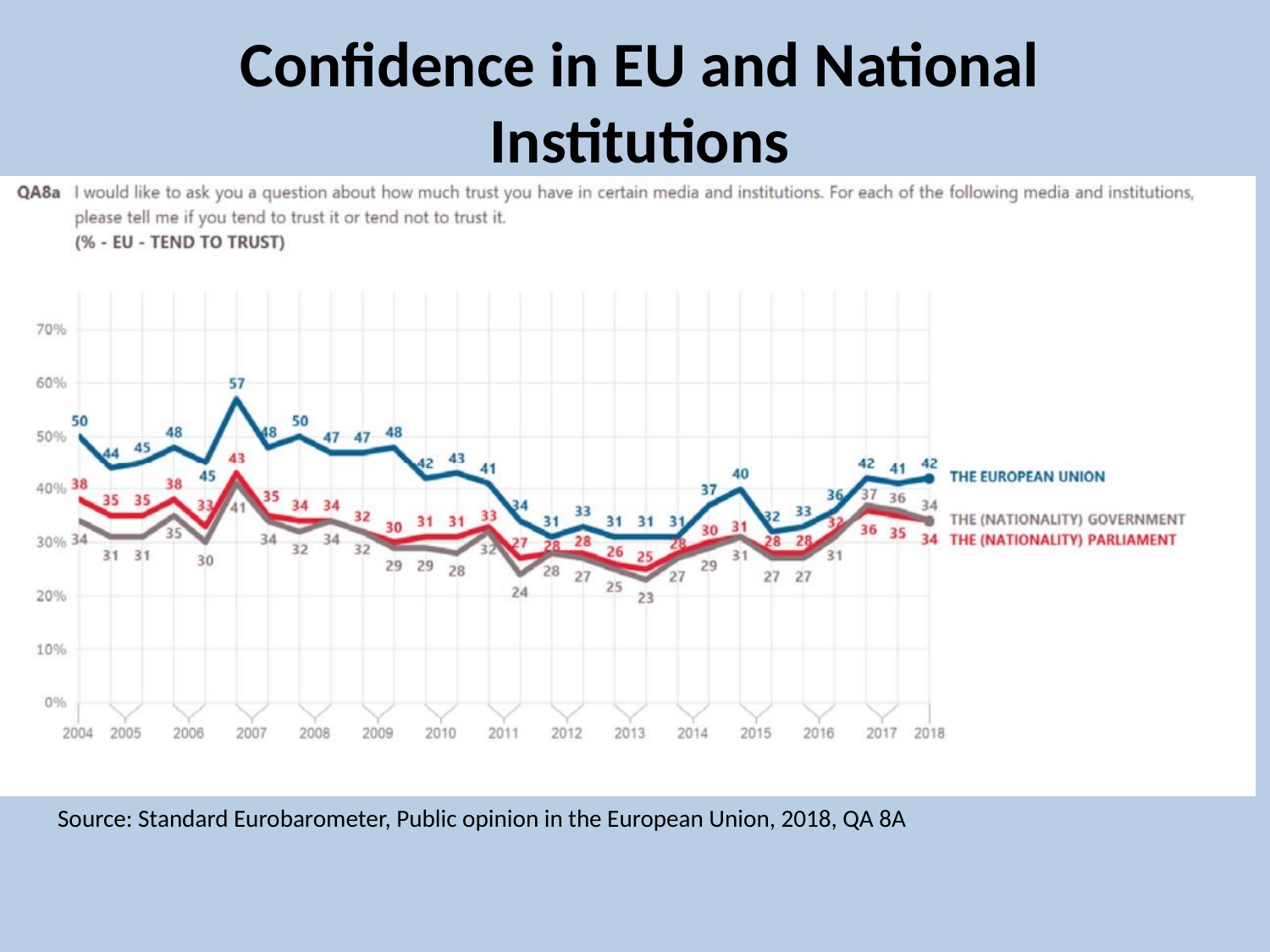
What is the value for The European Union in 2004? 50 In 2004, which is larger: the value for The European Union or for The (Nationality) Government? The European Union What is the difference between The European Union and The (Nationality) Parliament values in 2018? 8 How many series does the chart show? 3 What is the highest value reached by The European Union line? 57 What is the value for The (Nationality) Parliament in 2004? 38 What kind of chart is shown on the slide? line chart What is the lowest value on The (Nationality) Government line? 23 Is the peak value of The European Union line in 2007 greater or less than 50%? greater What colour is The European Union line? blue What is the value for The (Nationality) Government in 2018? 34 What is the value for The European Union in 2018? 42